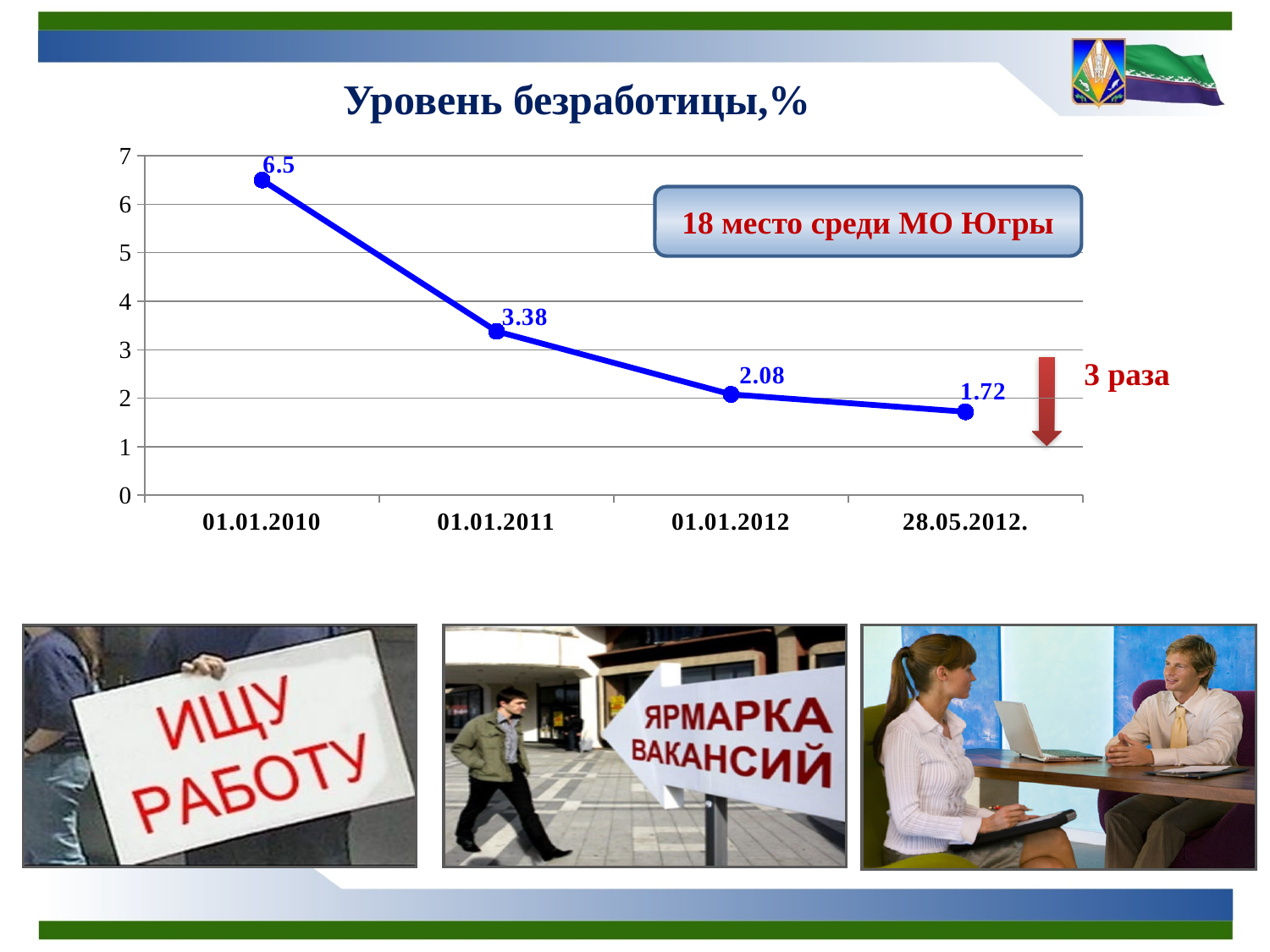
What is the unemployment rate value for 28.05.2012.? 1.72 What is the difference between the values for 01.01.2012 and 28.05.2012.? 0.36 Which is larger, the value for 01.01.2011 or the value for 01.01.2012? 01.01.2011 What is the unemployment rate value for 01.01.2010? 6.5 What kind of chart is shown on the slide? line chart What is the unemployment rate value for 01.01.2011? 3.38 What is the unemployment rate value for 01.01.2012? 2.08 How many data points are plotted on the chart? 4 Which date has the lowest unemployment rate? 28.05.2012. Which date has the highest unemployment rate? 01.01.2010 Do the values rise or fall along the x axis? fall What is the difference between the values for 01.01.2010 and 01.01.2011? 3.12